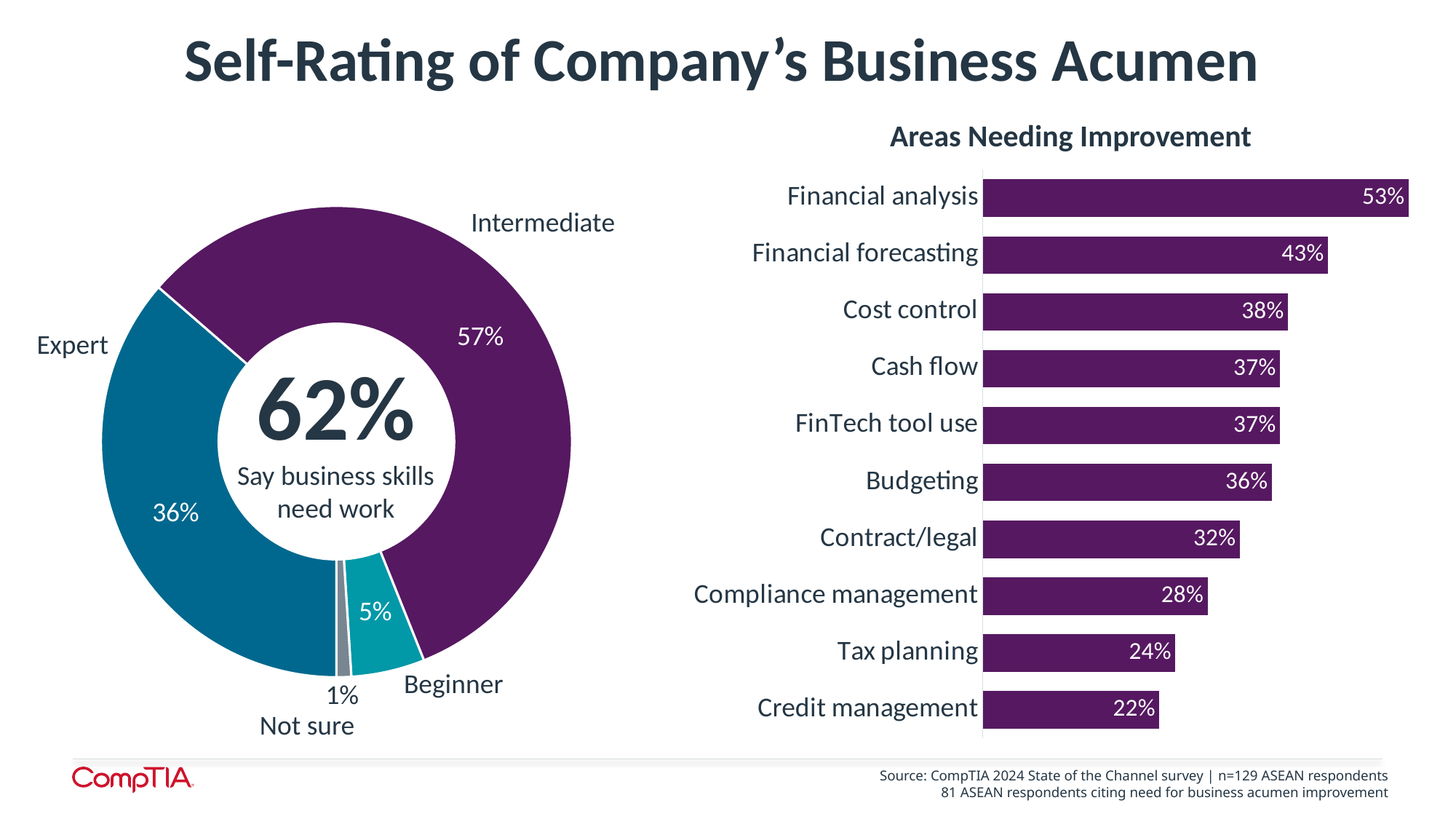
In the donut chart on the left, what share of respondents rated their company as Expert? 36% In the 'Areas Needing Improvement' chart, what is the value for Tax planning? 24% In the donut chart on the left, how many categories are shown? 4 In the 'Areas Needing Improvement' chart, how many areas are listed? 10 In the donut chart on the left, which category has the smallest share? Not sure In the 'Areas Needing Improvement' chart, which area has the highest value? Financial analysis In the donut chart on the left, what is the difference between the Intermediate and Expert shares? 21 percentage points In the 'Areas Needing Improvement' chart, what is the difference between Financial analysis and Financial forecasting? 10 percentage points What type of chart is 'Areas Needing Improvement'? Bar chart In the 'Areas Needing Improvement' chart, which area has the lowest value? Credit management In the donut chart on the left, what share of respondents rated their company's business acumen as Intermediate? 57% In the 'Areas Needing Improvement' chart, what is the value for Financial analysis? 53%